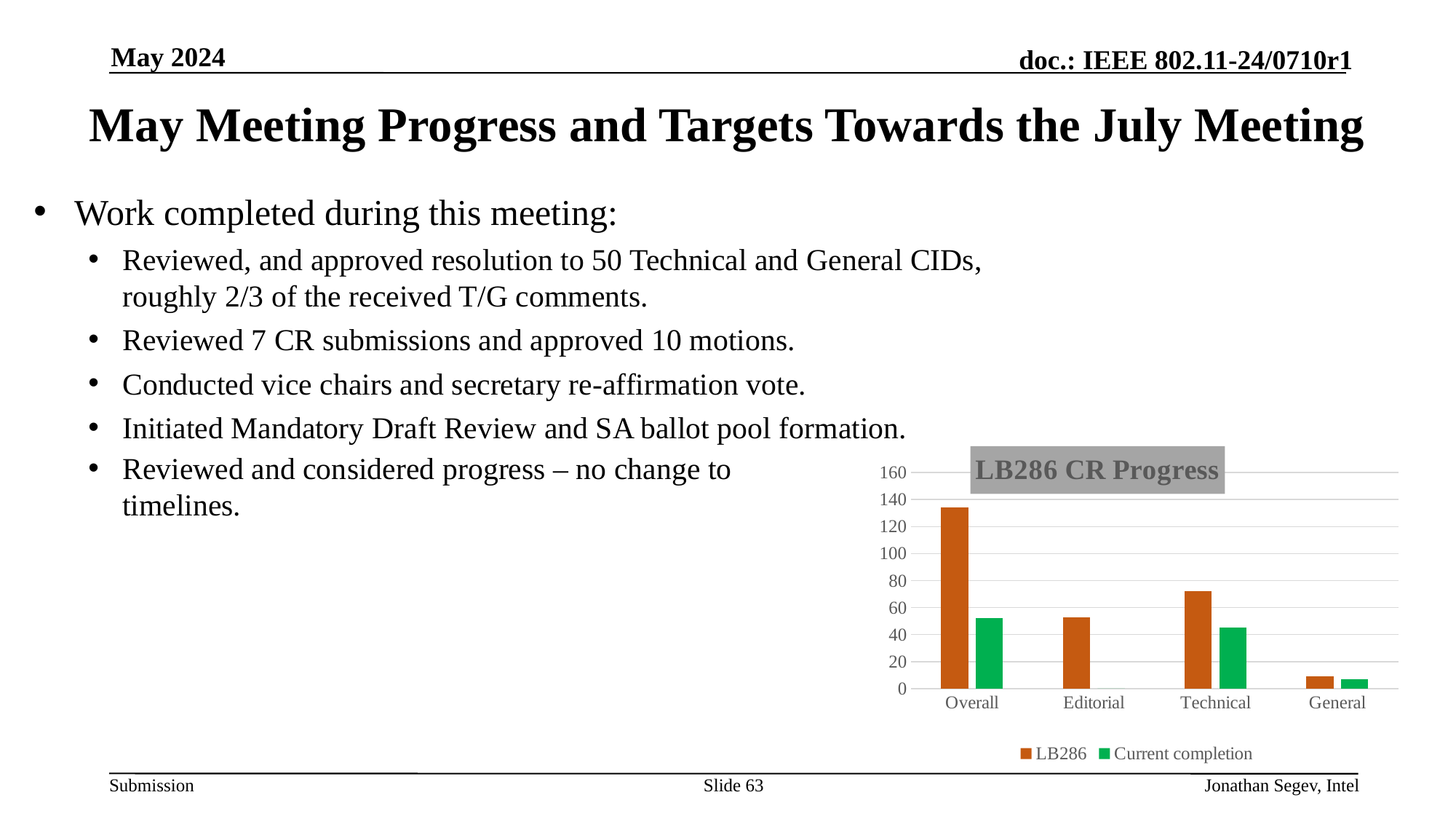
What kind of chart is shown on the slide? bar chart Which is larger, the LB286 value for Technical or the LB286 value for Editorial? Technical How many series does the chart legend list? 2 Is the LB286 value for General greater or less than 20? less Which series is shown in green in the chart? Current completion What is the title of the chart? LB286 CR Progress Is the LB286 value for Overall greater or less than 120? greater Is the LB286 value for Technical greater or less than 60? greater Which category has the lowest LB286 value? General How many categories are shown on the x axis of the chart? 4 Which category has the highest LB286 value? Overall